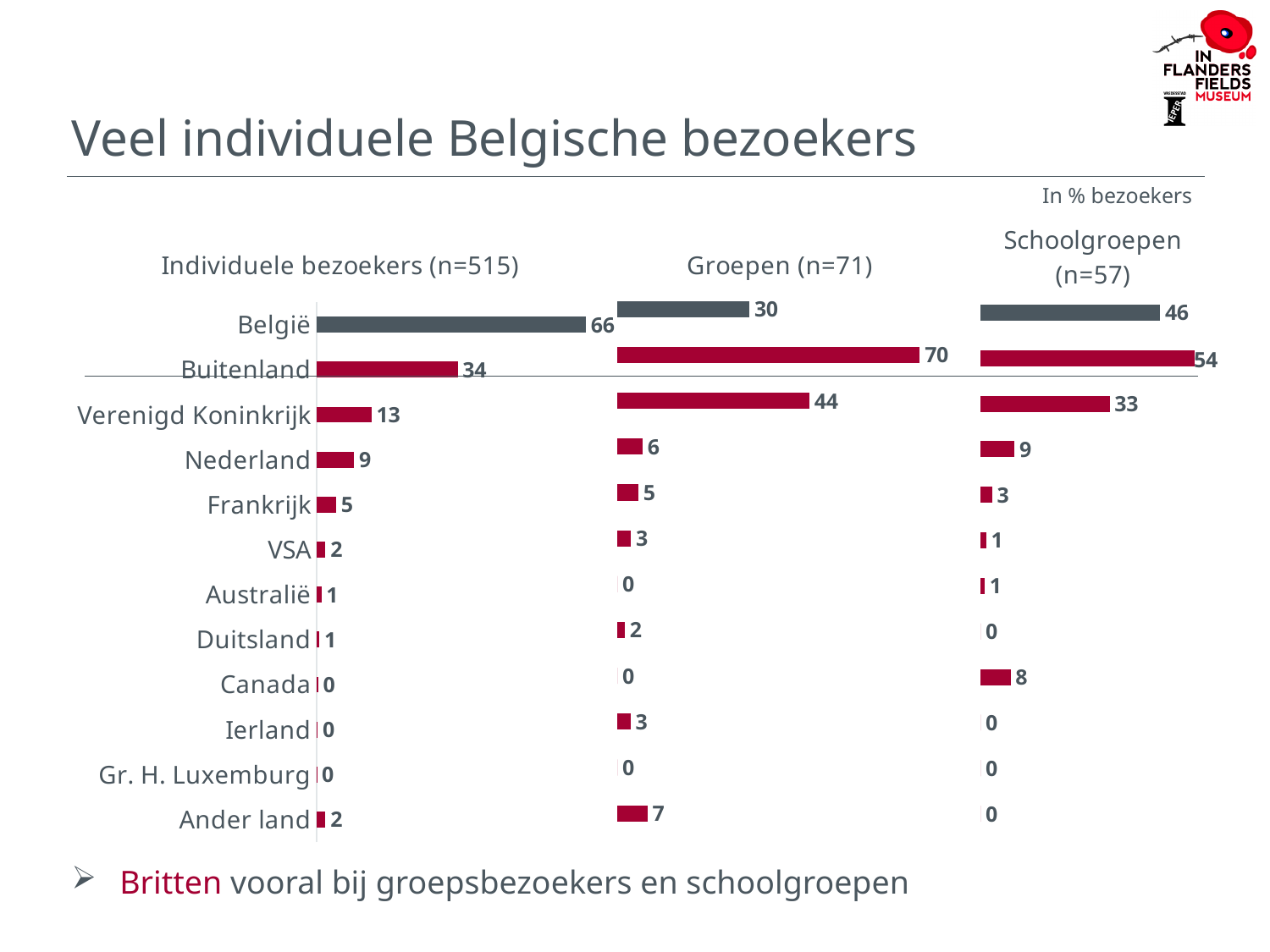
Which chart has the higher value for Ander land: 'Individuele bezoekers (n=515)' or 'Groepen (n=71)'? Groepen (n=71) In the 'Groepen (n=71)' chart, which category has the highest value? Buitenland In the 'Schoolgroepen (n=57)' chart, what is the value for Canada? 8 In the 'Individuele bezoekers (n=515)' chart, what is the value for België? 66 In the 'Schoolgroepen (n=57)' chart, what is the difference between Buitenland and België? 8 In the 'Groepen (n=71)' chart, what is the value for Buitenland? 70 In the 'Groepen (n=71)' chart, which is larger: the value for Verenigd Koninkrijk or the value for Nederland? Verenigd Koninkrijk In the 'Schoolgroepen (n=57)' chart, what is the value for Verenigd Koninkrijk? 33 How many categories are listed on the y axis of the 'Individuele bezoekers (n=515)' chart? 12 What kind of chart is the 'Groepen (n=71)' chart? Bar chart What unit do the values in the charts represent, according to the note at the top right? In % bezoekers In the 'Individuele bezoekers (n=515)' chart, what is the difference between België and Buitenland? 32